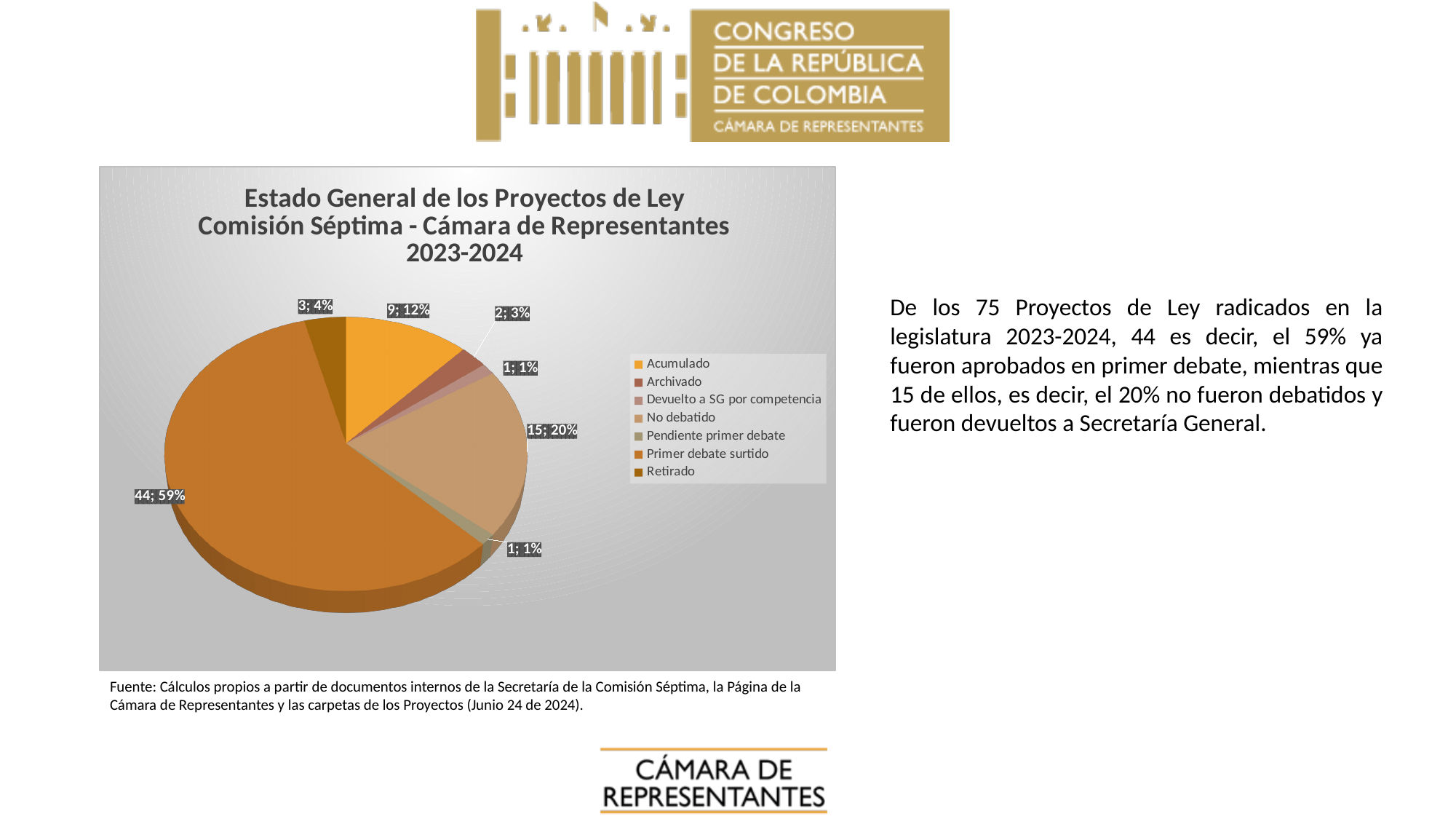
What share of the pie does Retirado represent? 4% What is the difference between the values for Primer debate surtido and No debatido? 29 What is the title of the chart? Estado General de los Proyectos de Ley Comisión Séptima - Cámara de Representantes 2023-2024 Which category has the largest slice of the pie? Primer debate surtido What is the value for Acumulado? 9 What is the value for Archivado? 2 What is the value for Primer debate surtido? 44 What share of the pie does No debatido represent? 20% How many categories does the pie chart show? 7 What is the total of all the values shown in the pie chart? 75 Which is larger, the value for Acumulado or the value for Retirado? Acumulado What kind of chart is shown on the slide? pie chart